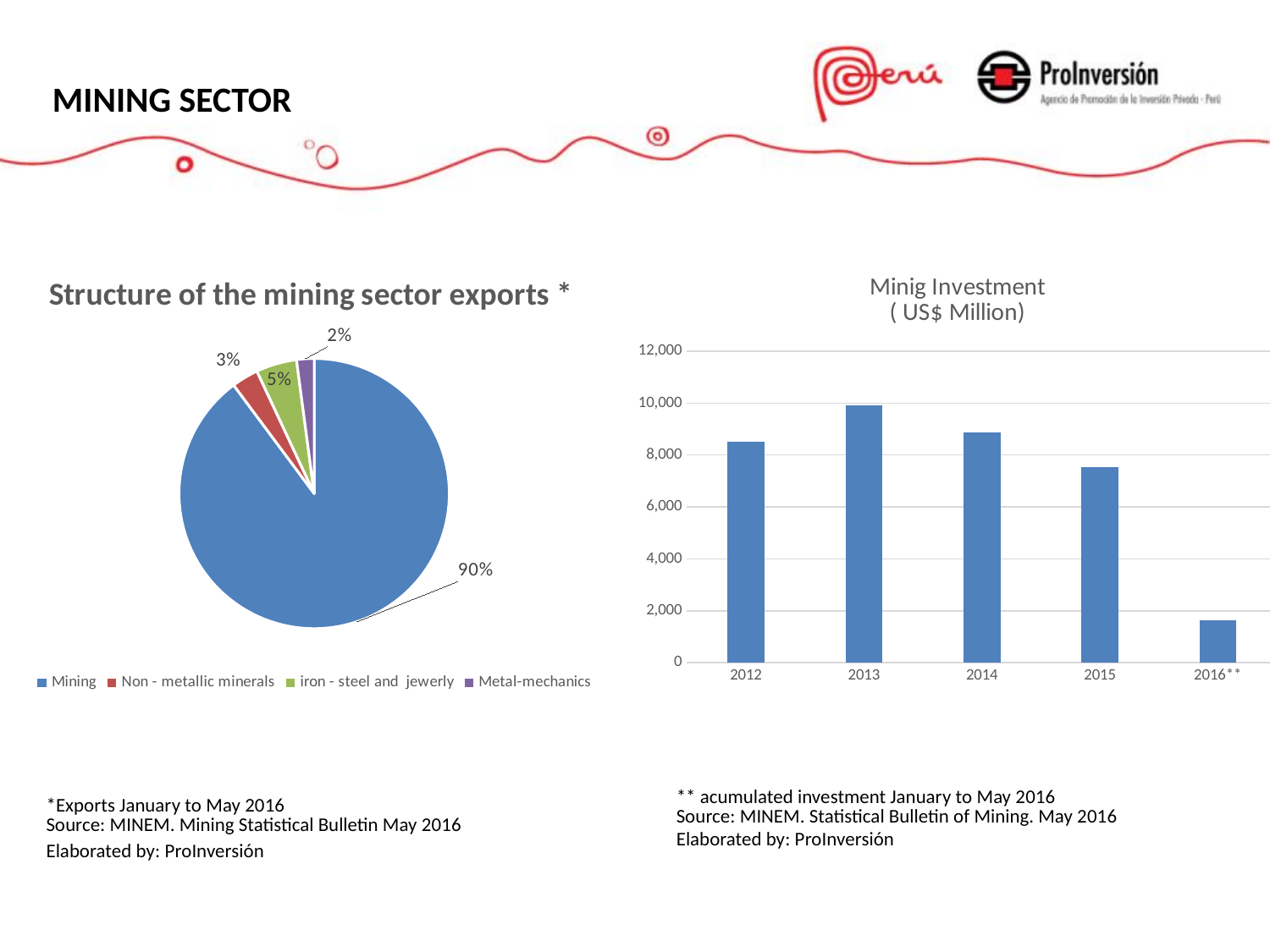
In the 'Minig Investment (US$ Million)' chart, which category has the lowest value? 2016** In the 'Minig Investment (US$ Million)' chart, is the value for 2015 greater or less than 8,000? less In the 'Structure of the mining sector exports' pie chart, which category has the smallest share? Metal-mechanics In the 'Minig Investment (US$ Million)' chart, is the value for 2014 greater or less than 8,000? greater In the 'Structure of the mining sector exports' pie chart, what is the difference between the shares of 'iron - steel and jewerly' and 'Non - metallic minerals'? 2% What kind of chart is 'Minig Investment (US$ Million)'? Bar chart In the 'Structure of the mining sector exports' pie chart, what share does Metal-mechanics account for? 2% In the 'Structure of the mining sector exports' pie chart, what share does Mining account for? 90% In the 'Minig Investment (US$ Million)' chart, how many years are shown on the x axis? 5 In the 'Minig Investment (US$ Million)' chart, which year has the highest investment? 2013 In the 'Structure of the mining sector exports' pie chart, how many categories does the legend list? 4 In the 'Structure of the mining sector exports' pie chart, what share does 'iron - steel and jewerly' account for? 5%